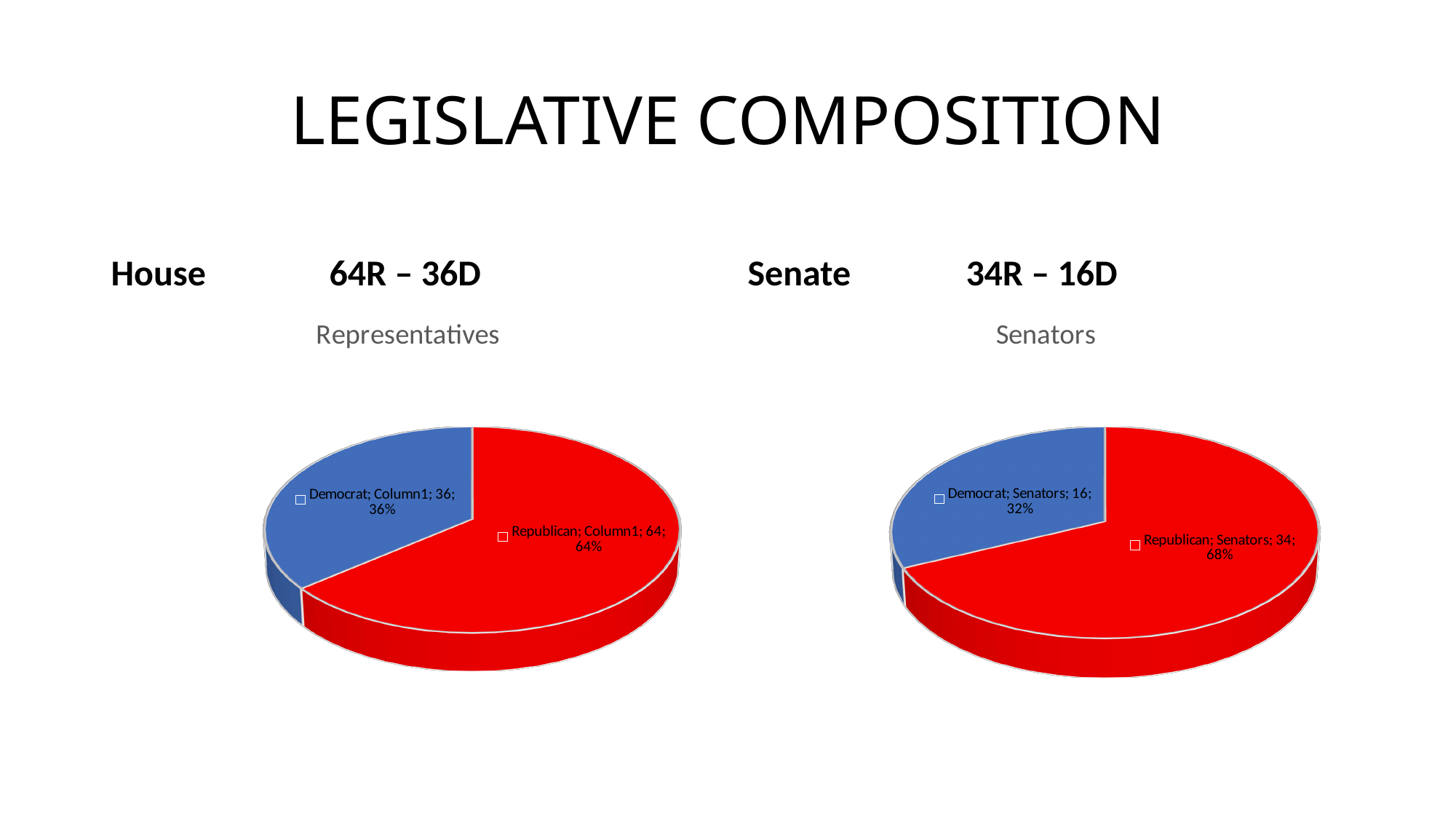
What kind of chart is the Senators chart? Pie chart In the Senators chart, what value is shown for Republican? 34 In the Senators chart, what is the difference between the Republican and Democrat values? 18 In the Representatives chart, what share of the pie does the Democrat slice represent? 36% In the Senators chart, what value is shown for Democrat? 16 In the Senators chart, what share of the pie does the Republican slice represent? 68% In the Representatives chart, what value is shown for Democrat? 36 In the Representatives chart, what value is shown for Republican? 64 In the Representatives chart, which category has the largest slice? Republican How many slices does the Representatives chart have? 2 In the Representatives chart, what is the total of the Republican and Democrat values? 100 In the Senators chart, which category has the smallest slice? Democrat